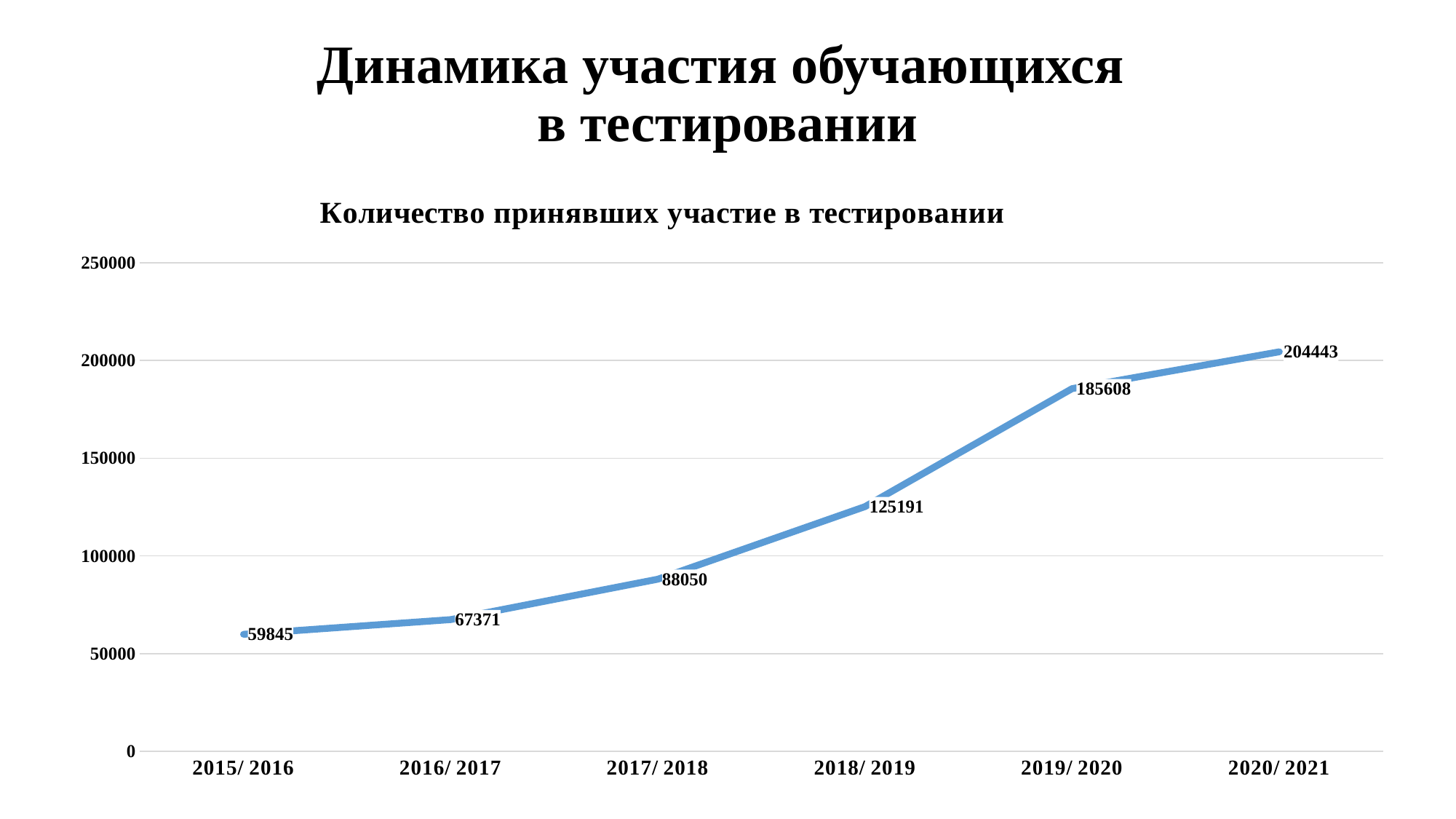
What is the difference in participants between 2019/2020 and 2018/2019? 60417 What is the difference in participants between 2016/2017 and 2015/2016? 7526 How many academic years are shown on the x axis? 6 What is the number of participants in testing for 2020/2021? 204443 What is the number of participants in testing for 2018/2019? 125191 What kind of chart is shown on the slide? line chart What is the number of participants in testing for 2015/2016? 59845 Is the value for 2019/2020 greater or less than 200000? less Which academic year has the highest number of participants in testing? 2020/2021 Do the values rise or fall from 2015/2016 to 2020/2021? rise Which year had more participants, 2017/2018 or 2018/2019? 2018/2019 Which academic year has the lowest number of participants in testing? 2015/2016